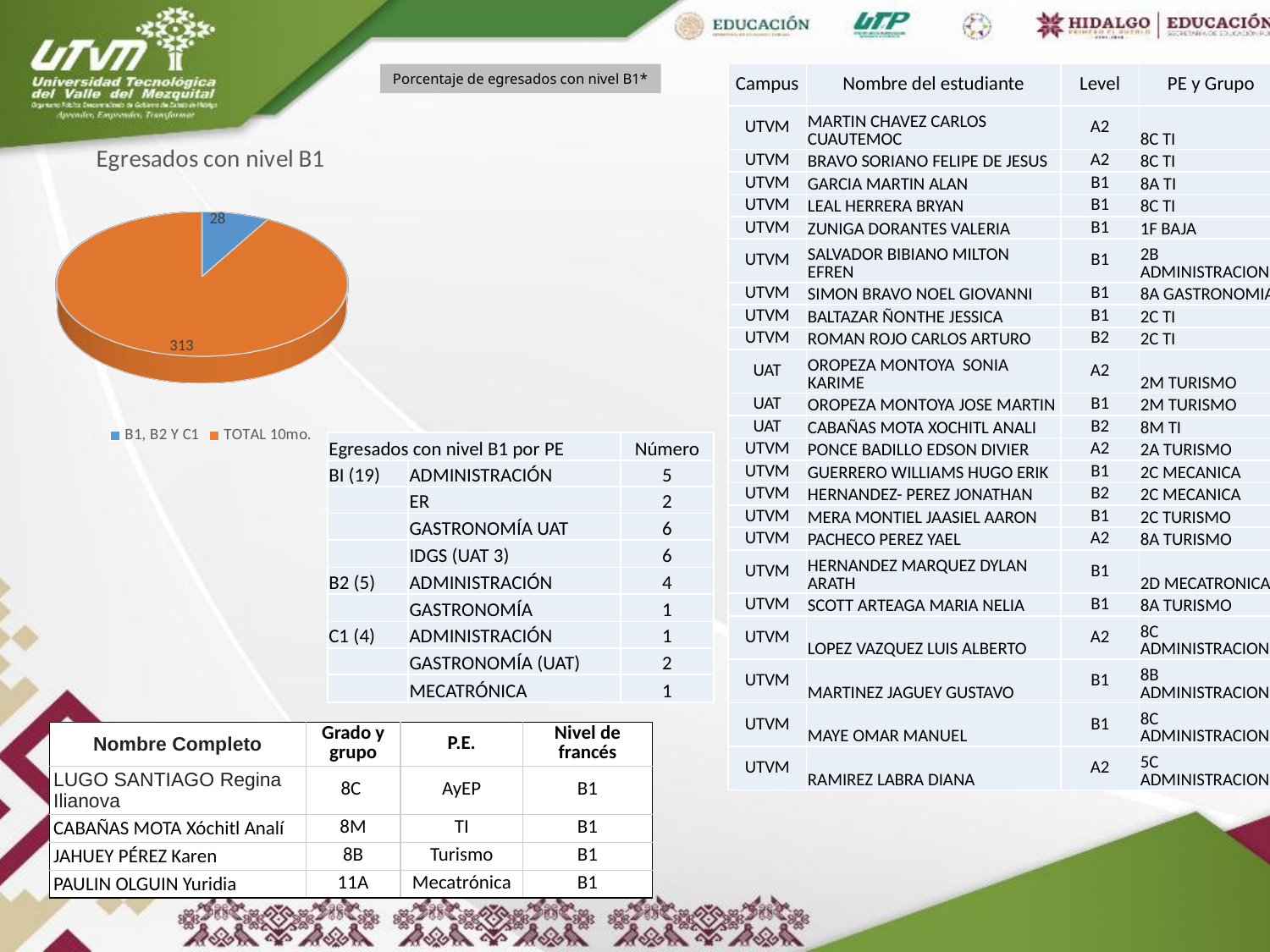
How many entries does the legend of the pie chart list? 2 Which slice of the pie chart is the smallest? B1, B2 Y C1 In the pie chart, which is larger: "B1, B2 Y C1" or "TOTAL 10mo."? TOTAL 10mo. Which slice of the pie chart is the largest? TOTAL 10mo. In the pie chart, what is the value of the "B1, B2 Y C1" slice? 28 What is the total of the two slices shown in the pie chart? 341 What is the difference between the "TOTAL 10mo." slice and the "B1, B2 Y C1" slice in the pie chart? 285 In the pie chart, what is the value of the "TOTAL 10mo." slice? 313 How many slices does the pie chart have? 2 What type of chart is shown under the title "Egresados con nivel B1"? pie chart What colour is the "B1, B2 Y C1" slice in the pie chart? blue What is the title of the pie chart? Egresados con nivel B1